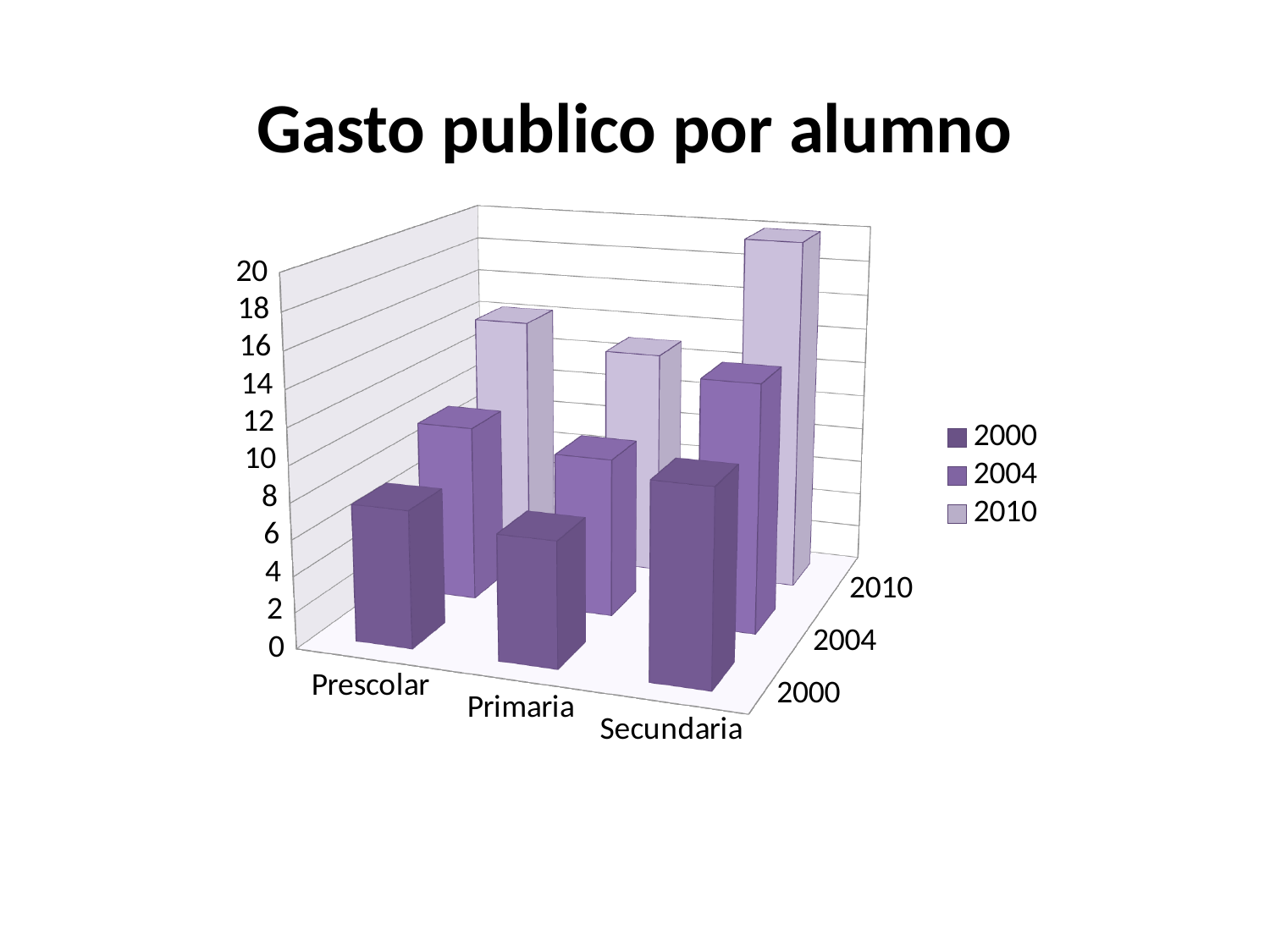
Which is larger in the 2010 series, Secundaria or Primaria? Secundaria Which category has the tallest bar in the 2010 series? Secundaria Which series has the tallest bar for Secundaria? 2010 What kind of chart is shown on the slide? bar chart Is the value for Secundaria in 2010 greater or less than 14? greater How many categories are shown along the x axis? 3 Do the values for Secundaria rise or fall from 2000 to 2010? rise How many series does the legend list? 3 What is the title of the chart? Gasto publico por alumno Is the value for Prescolar in 2010 greater or less than 10? greater Is the value for Prescolar in 2000 greater or less than 10? less Which is larger in the 2000 series, Secundaria or Prescolar? Secundaria